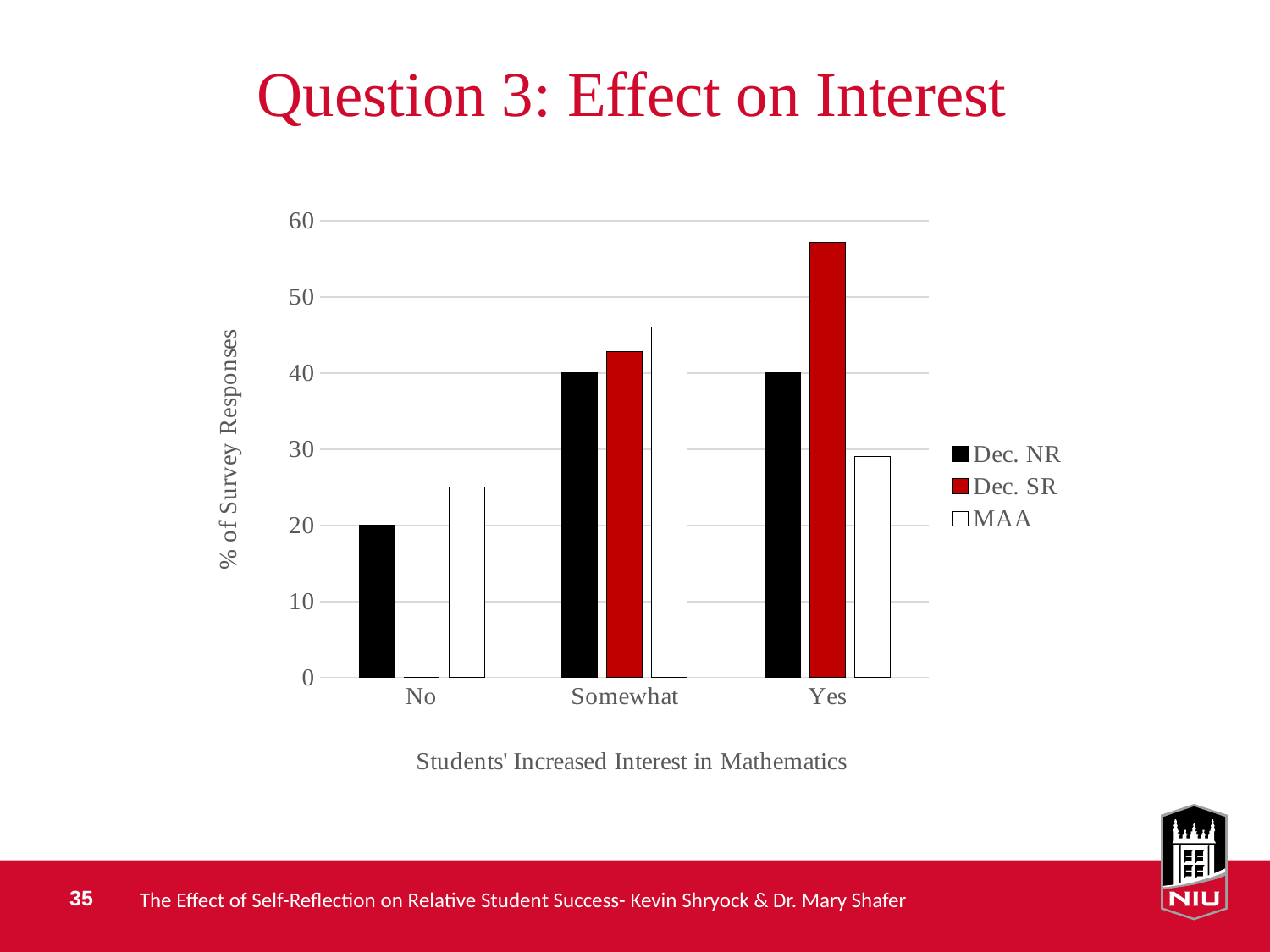
Which is larger in the Yes category, Dec. SR or MAA? Dec. SR Is the value for Dec. SR in the Yes category greater or less than 50? greater What is the value for Dec. NR in the No category? 20 What is the value for Dec. SR in the No category? 0 What is the value for Dec. NR in the Somewhat category? 40 Is the value for MAA in the Somewhat category greater or less than 40? greater Which series has the highest bar in the No category? MAA How many series does the legend list? 3 How many categories are shown on the x axis? 3 What is the title of the x axis? Students' Increased Interest in Mathematics What kind of chart is shown on the slide? bar chart Which series has the highest bar in the Yes category? Dec. SR